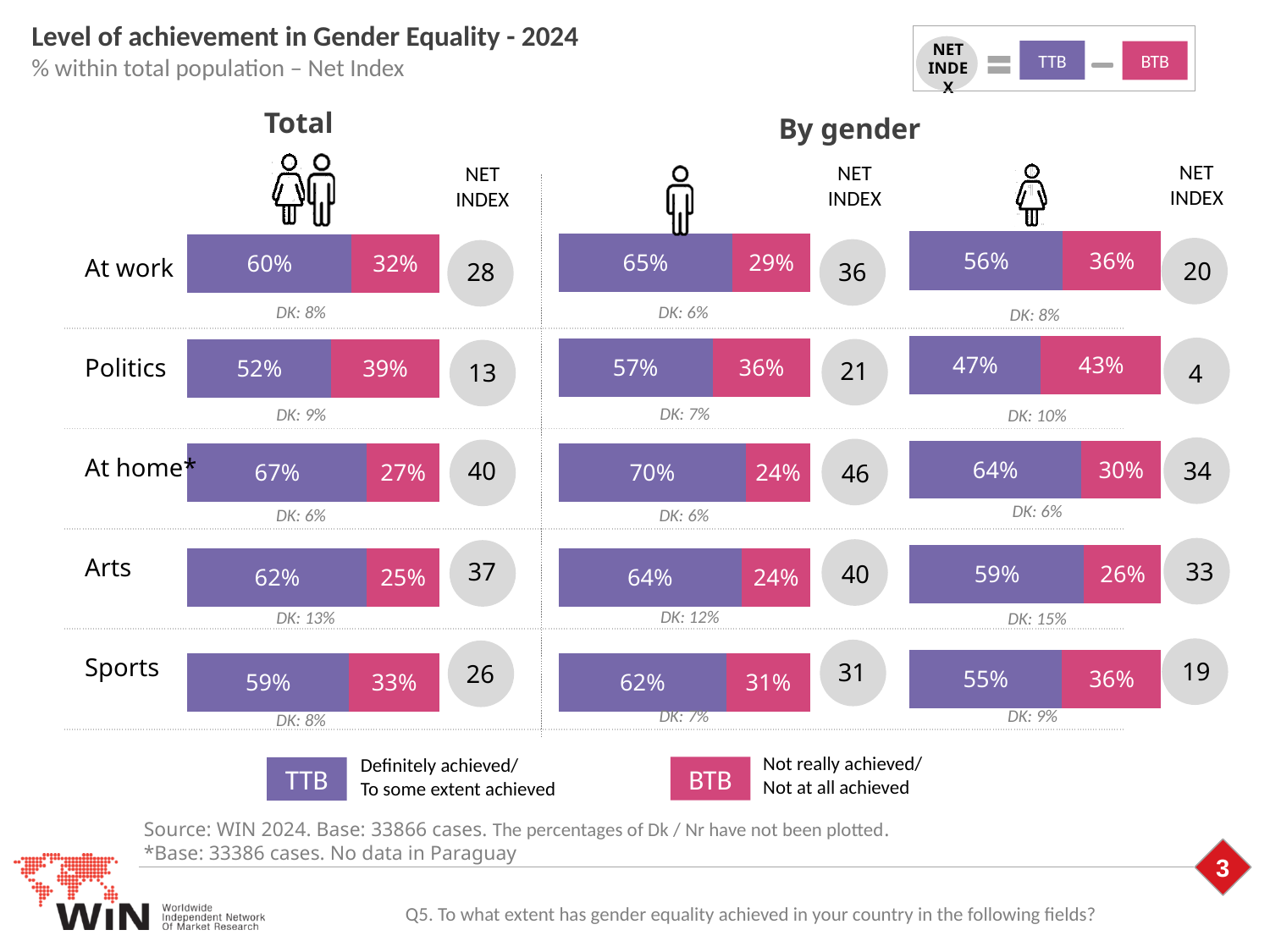
In the Total chart, what is the combined TTB and BTB value for At work? 92% In the men's chart under By gender, what is the difference between the TTB and BTB values for Sports? 31 In the Total chart, what is the BTB value for Politics? 39% What kind of chart is used in the Total panel? Stacked bar chart How many series does the legend at the bottom of the slide list? 2 In the women's chart under By gender, what is the Net Index for Politics? 4 In the men's chart under By gender, what is the TTB value for At home? 70% How many categories are shown in the Total chart? 5 In the Total chart, which is larger: the BTB value for Arts or the BTB value for Sports? Sports In the Total chart, which category has the highest TTB value? At home In the Total chart, what is the TTB value for At work? 60% In the women's chart under By gender, which category has the lowest TTB value? Politics